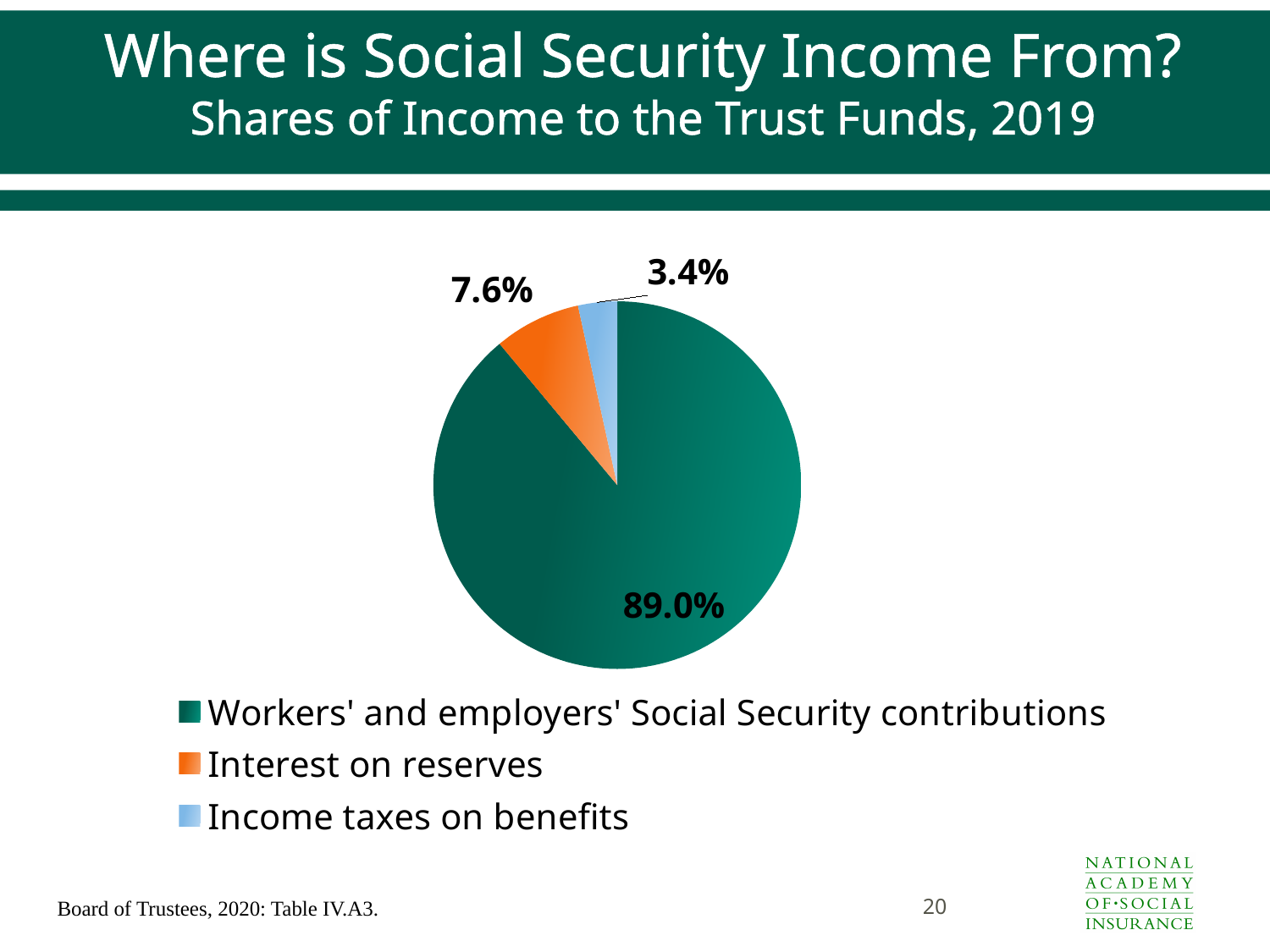
What is the subtitle of the chart on the slide? Shares of Income to the Trust Funds, 2019 Which source accounts for the smallest share of income to the trust funds? Income taxes on benefits What colour represents income taxes on benefits in the pie chart? Light blue What share of income to the trust funds comes from income taxes on benefits? 3.4% How many percentage points larger is the share from workers' and employers' contributions than the share from interest on reserves? 81.4 percentage points What share of income to the trust funds comes from interest on reserves? 7.6% What kind of chart is shown on the slide? Pie chart Which source accounts for the largest share of income to the trust funds? Workers' and employers' Social Security contributions Which is larger: the share from interest on reserves or the share from income taxes on benefits? Interest on reserves How many income sources are shown in the pie chart? 3 What share of income to the trust funds comes from workers' and employers' Social Security contributions? 89.0% How many percentage points larger is the share from interest on reserves than the share from income taxes on benefits? 4.2 percentage points